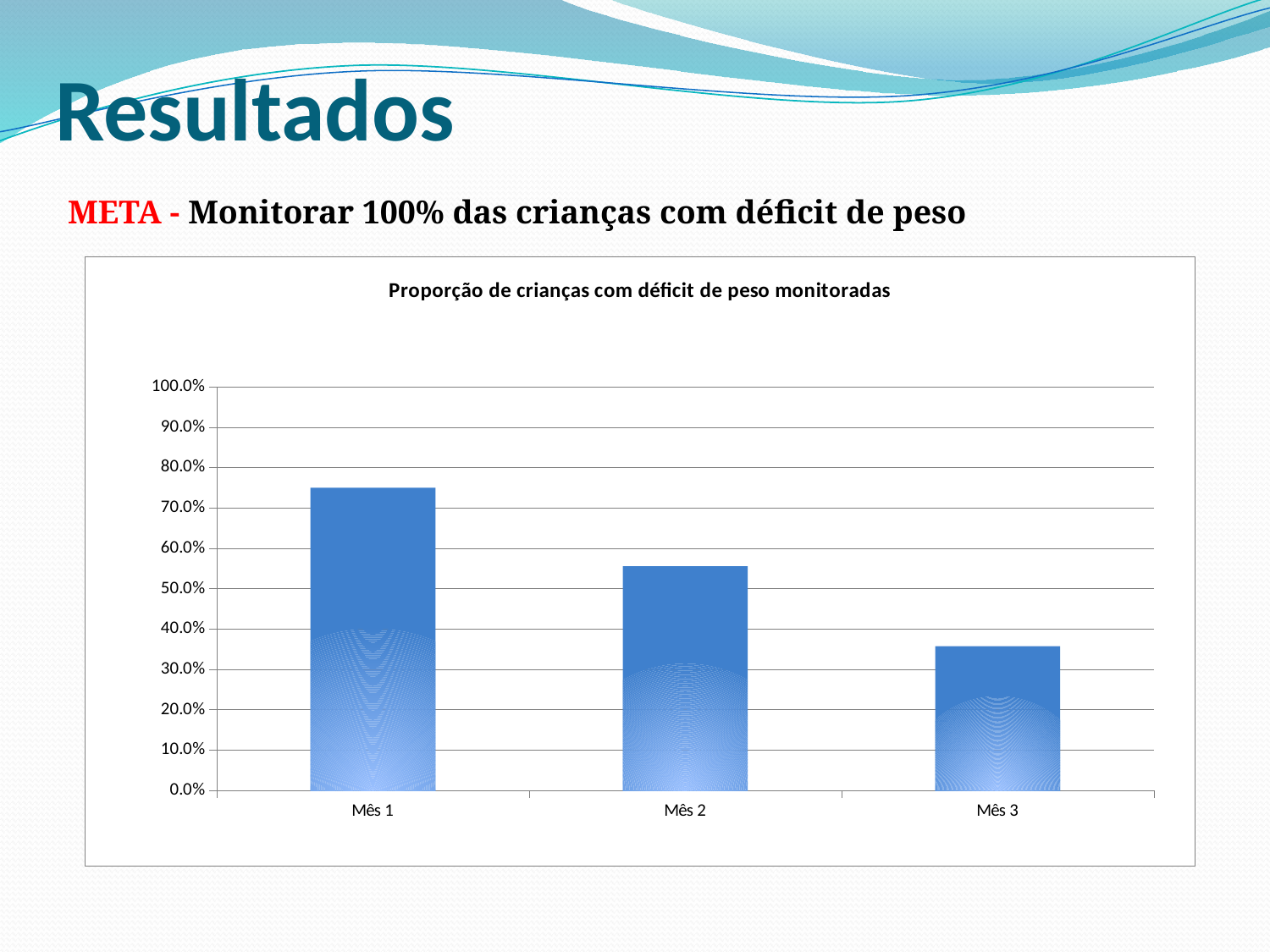
How many categories are shown on the x axis of the chart? 3 Do the values rise or fall from Mês 1 to Mês 3? fall Is the value for Mês 1 greater or less than 70.0%? greater Which month has the highest proportion of monitored children? Mês 1 Is the value for Mês 2 greater or less than 60.0%? less Which is larger, the value for Mês 2 or the value for Mês 3? Mês 2 What is the title of the chart? Proporção de crianças com déficit de peso monitoradas What is the maximum value shown on the y axis of the chart? 100.0% Is the value for Mês 3 greater or less than 40.0%? less What kind of chart is shown on the slide? bar chart Which month has the lowest proportion of monitored children? Mês 3